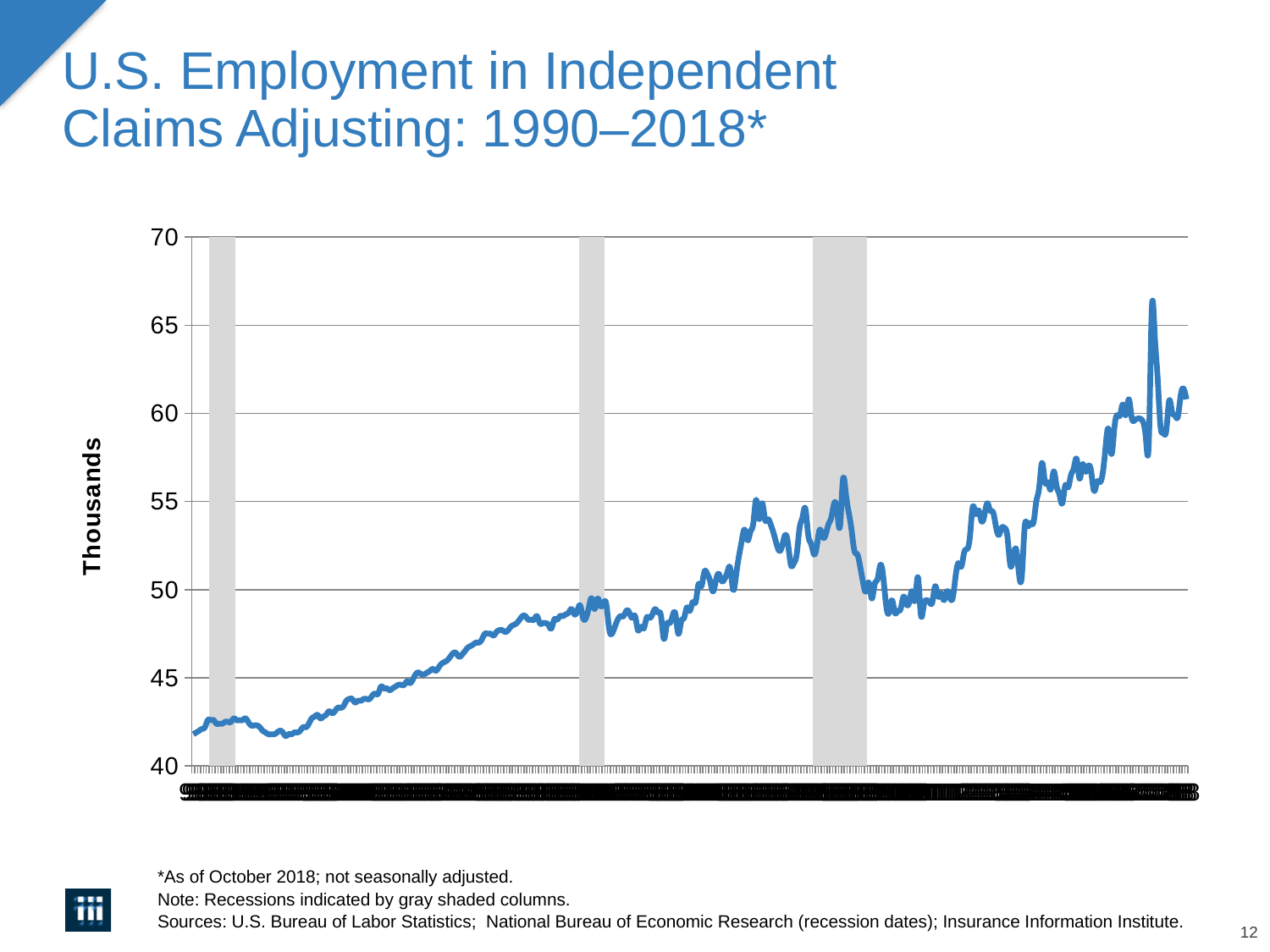
Is the lowest point of the line greater or less than 45? less Is the value at the end of the series larger or smaller than the value at the start of the series? larger Is the highest point reached by the line greater or less than 65? greater How many data series are plotted on the chart? 1 Is the value at the end of the series (right end of the line) greater or less than 55? greater What is the highest value shown on the vertical axis of the chart? 70 Overall, do the values on the chart rise or fall from the left of the x axis to the right? rise What is the label on the vertical axis of the chart? Thousands What kind of chart is shown on the slide? line chart What is the title of the chart on the slide? U.S. Employment in Independent Claims Adjusting: 1990–2018*